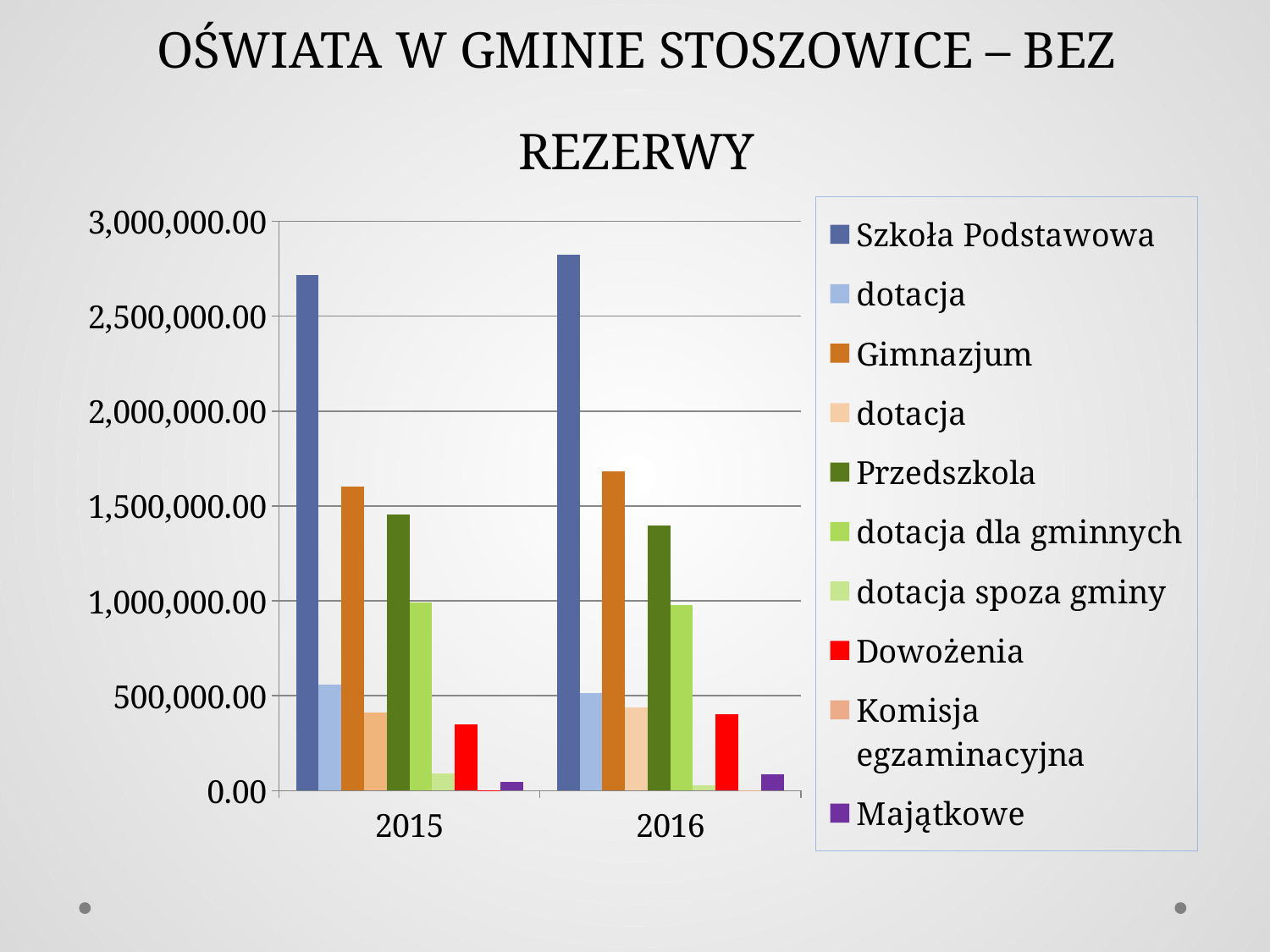
Is the value for Gimnazjum in 2015 greater or less than 2,000,000.00? less Is the value for Szkoła Podstawowa in 2016 greater or less than 2,500,000.00? greater Which is larger: Gimnazjum in 2015 or Przedszkola in 2015? Gimnazjum What kind of chart is shown on the slide? bar chart Is the value for Dowożenia in 2016 greater or less than 500,000.00? less Does the value for Szkoła Podstawowa rise or fall from 2015 to 2016? rise Which series has the highest value in 2015? Szkoła Podstawowa How many series does the legend list? 10 Which series has the lowest value in 2016? Komisja egzaminacyjna What is the title of the chart? OŚWIATA W GMINIE STOSZOWICE – BEZ REZERWY Which series has the highest value in 2016? Szkoła Podstawowa How many categories (years) are shown on the x axis? 2